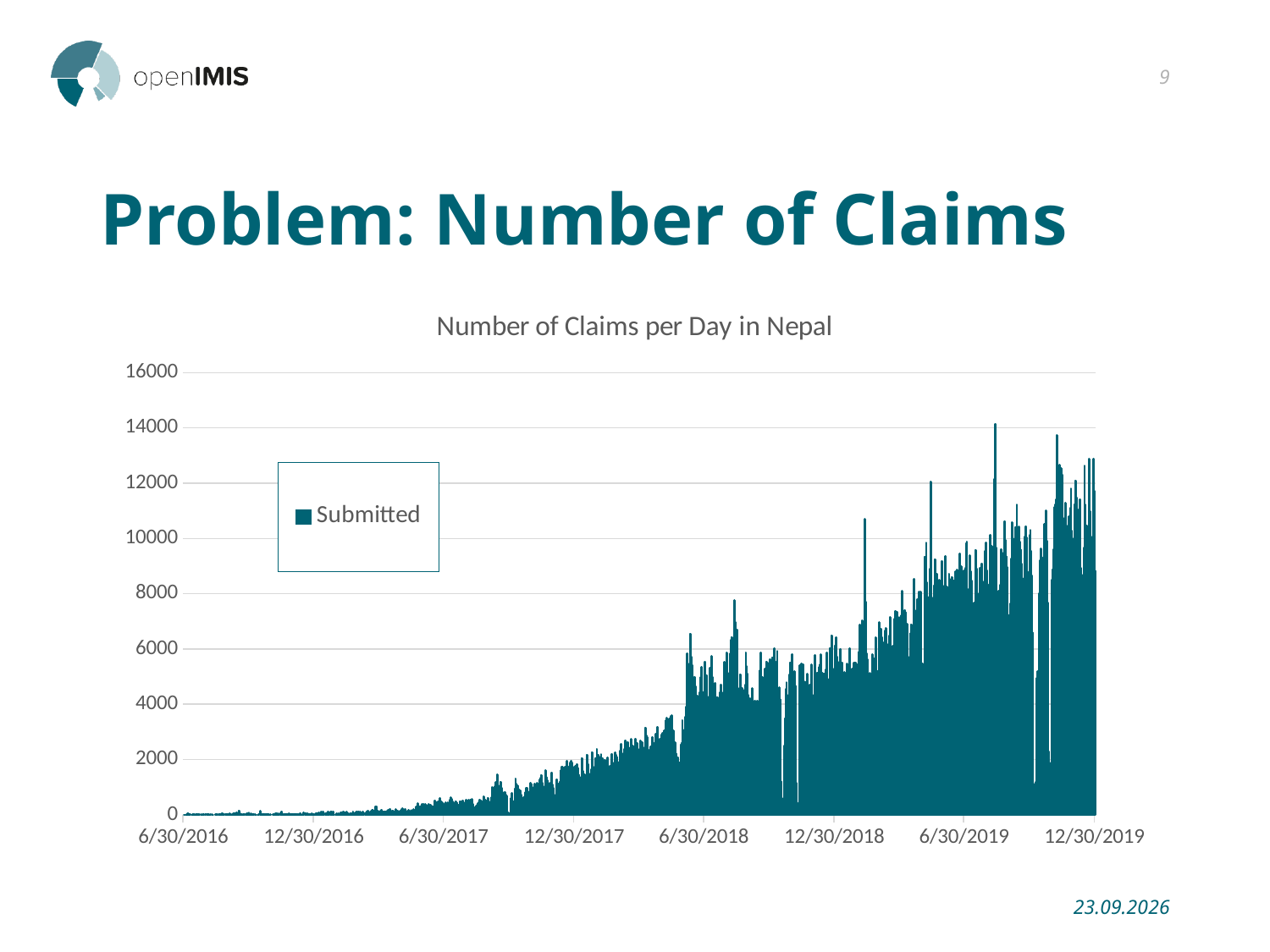
What is the first date label on the horizontal axis? 6/30/2016 Which period has higher daily values: around 6/30/2017 or around 6/30/2019? around 6/30/2019 What is the highest value shown on the vertical axis? 16000 What is the name of the series shown in the legend? Submitted Do the values generally rise or fall from 6/30/2016 to 12/30/2019? rise Is the highest daily value on the chart greater or less than 12000? greater Is the value for 6/30/2016 greater or less than 2000? less Is the value for 6/30/2017 greater or less than 4000? less How many series does the chart's legend list? 1 What is the title of the chart? Number of Claims per Day in Nepal What kind of chart is shown on the slide? bar chart